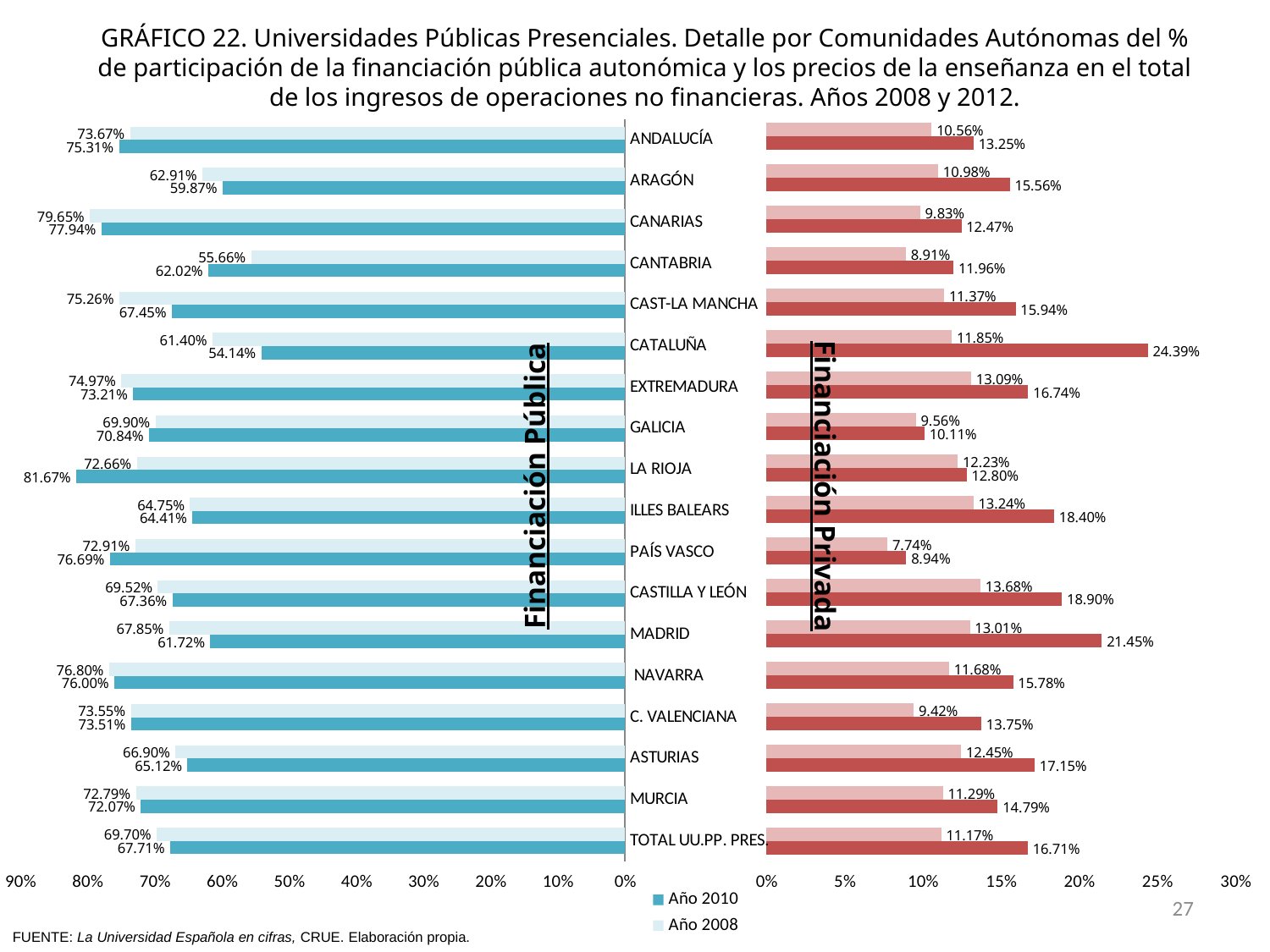
In the Financiación Privada chart, which community has the lowest Año 2008 value? PAÍS VASCO In the Financiación Privada chart, what is the Año 2010 value for MADRID? 21.45% In the Financiación Pública chart, which community has the lowest Año 2010 value? CATALUÑA In the Financiación Pública chart, what is the Año 2010 value for TOTAL UU.PP. PRES.? 67.71% In the Financiación Privada chart, what is the Año 2008 value for PAÍS VASCO? 7.74% How many series does the legend list? 2 In the Financiación Pública chart, which community has the highest Año 2010 value? LA RIOJA In the Financiación Pública chart, which is larger for ARAGÓN: the Año 2008 value or the Año 2010 value? Año 2008 In the Financiación Privada chart, what is the difference between the Año 2010 and Año 2008 values for CATALUÑA? 12.54 percentage points In the Financiación Privada chart, which community has the highest Año 2010 value? CATALUÑA In the Financiación Pública chart, what is the Año 2010 value for CATALUÑA? 54.14% How many categories (communities plus the total) are shown in the Financiación Pública chart? 18